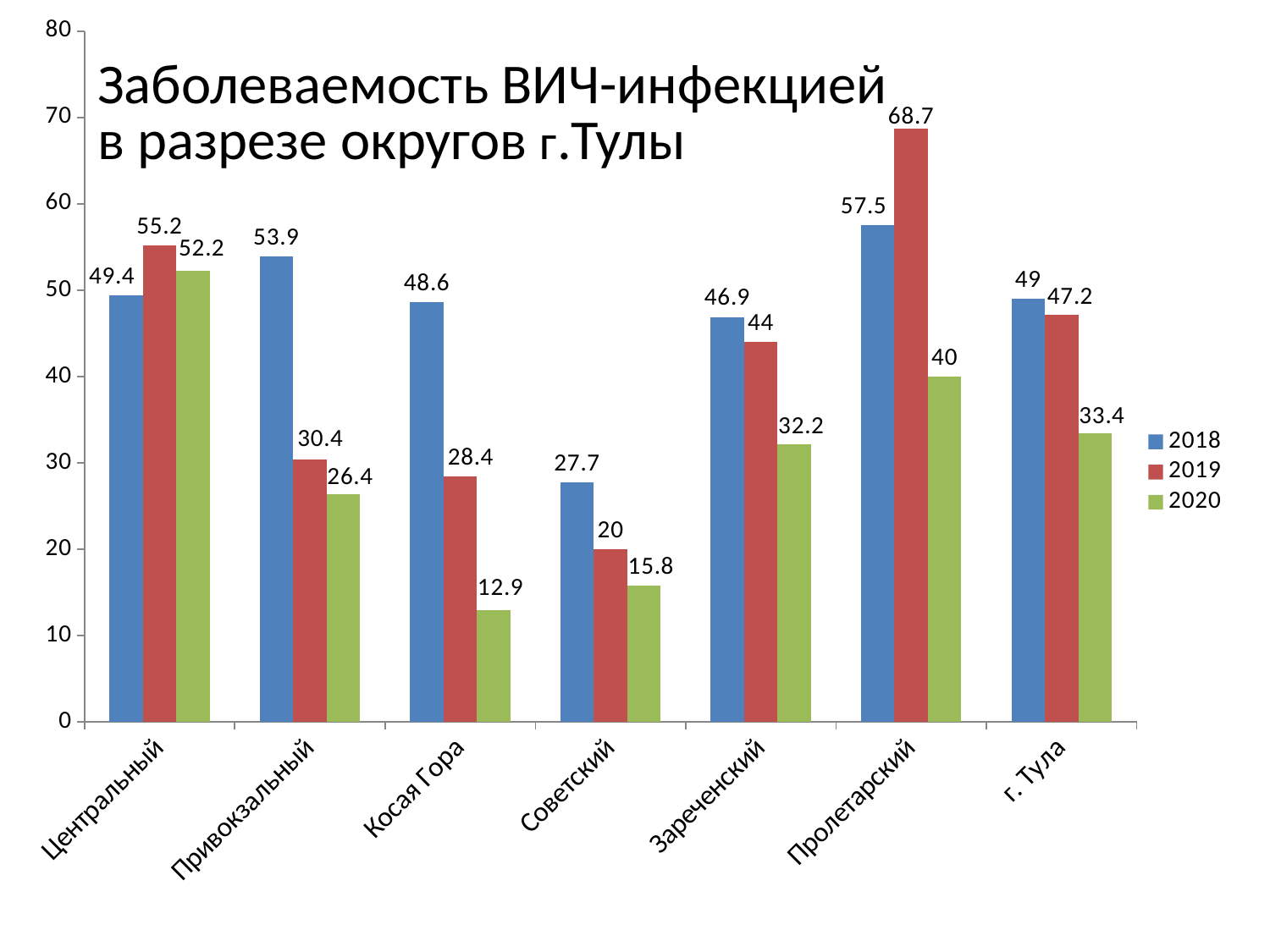
Which category has the highest 2019 value? Пролетарский Is the 2018 value for Зареченский greater or less than 40? greater What is the 2018 value for Советский? 27.7 What kind of chart is shown? bar chart Which category has the lowest 2020 value? Косая Гора What is the 2019 value for Пролетарский? 68.7 What is the title of the chart? Заболеваемость ВИЧ-инфекцией в разрезе округов г.Тулы Which is larger for Центральный: the 2019 value or the 2020 value? 2019 What is the difference between the 2018 and 2020 values for Привокзальный? 27.5 What is the 2020 value for Косая Гора? 12.9 How many series does the legend list? 3 How many categories are shown on the x axis? 7